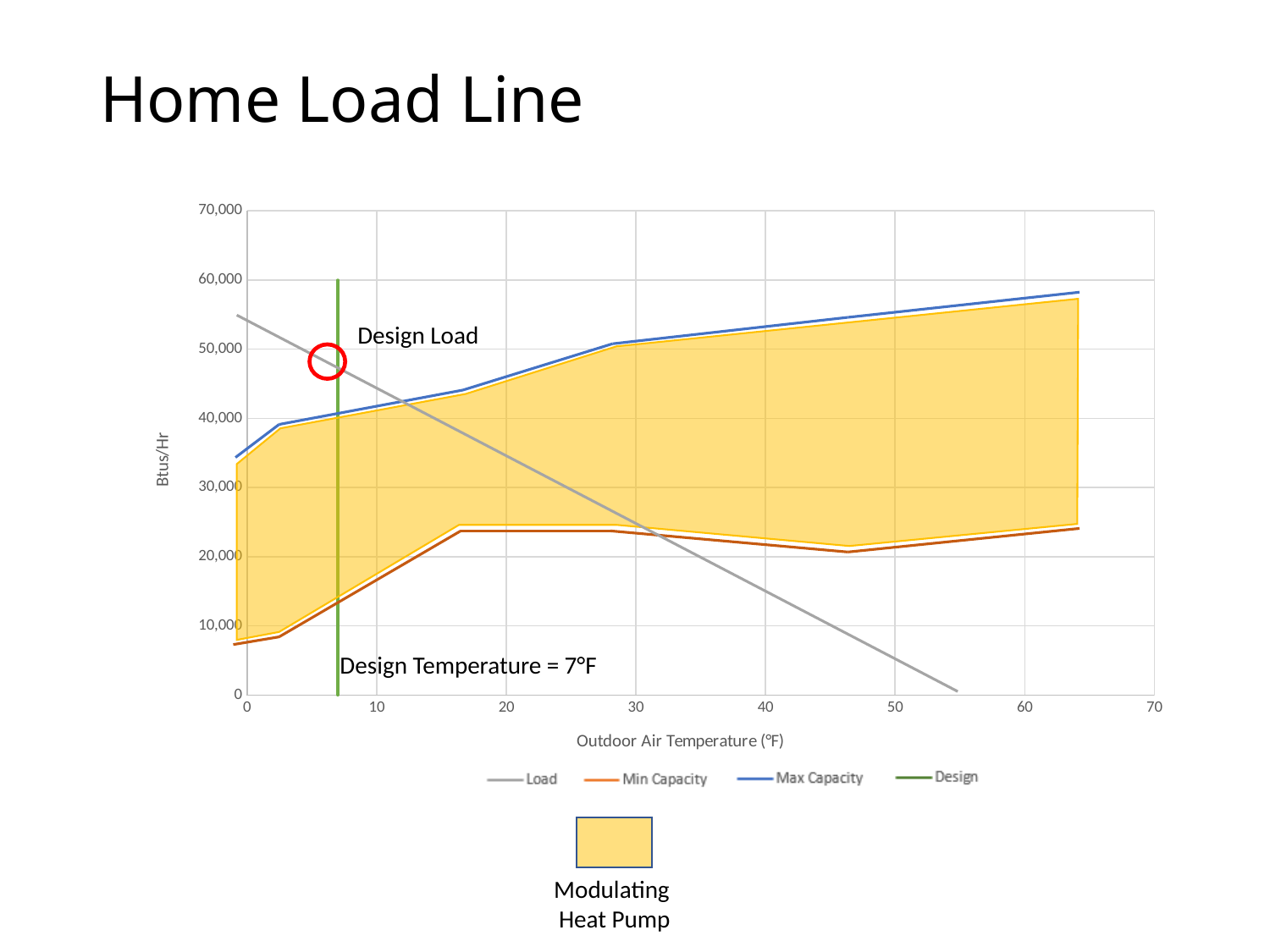
How many series does the chart legend list? 4 At 30°F, which is larger: Max Capacity or Load? Max Capacity Does the Max Capacity line rise or fall as outdoor air temperature increases? rise What kind of chart is shown on the slide? line chart What is the label on the vertical axis of the chart? Btus/Hr Is the Min Capacity value at 40°F greater or less than 30,000? less Does the Load line rise or fall as outdoor air temperature increases? fall Which series are listed in the chart legend? Load, Min Capacity, Max Capacity, Design Is the Max Capacity value at 60°F greater or less than 50,000? greater Is the Max Capacity value at 0°F greater or less than 40,000? less At 50°F, which is larger: Min Capacity or Load? Min Capacity